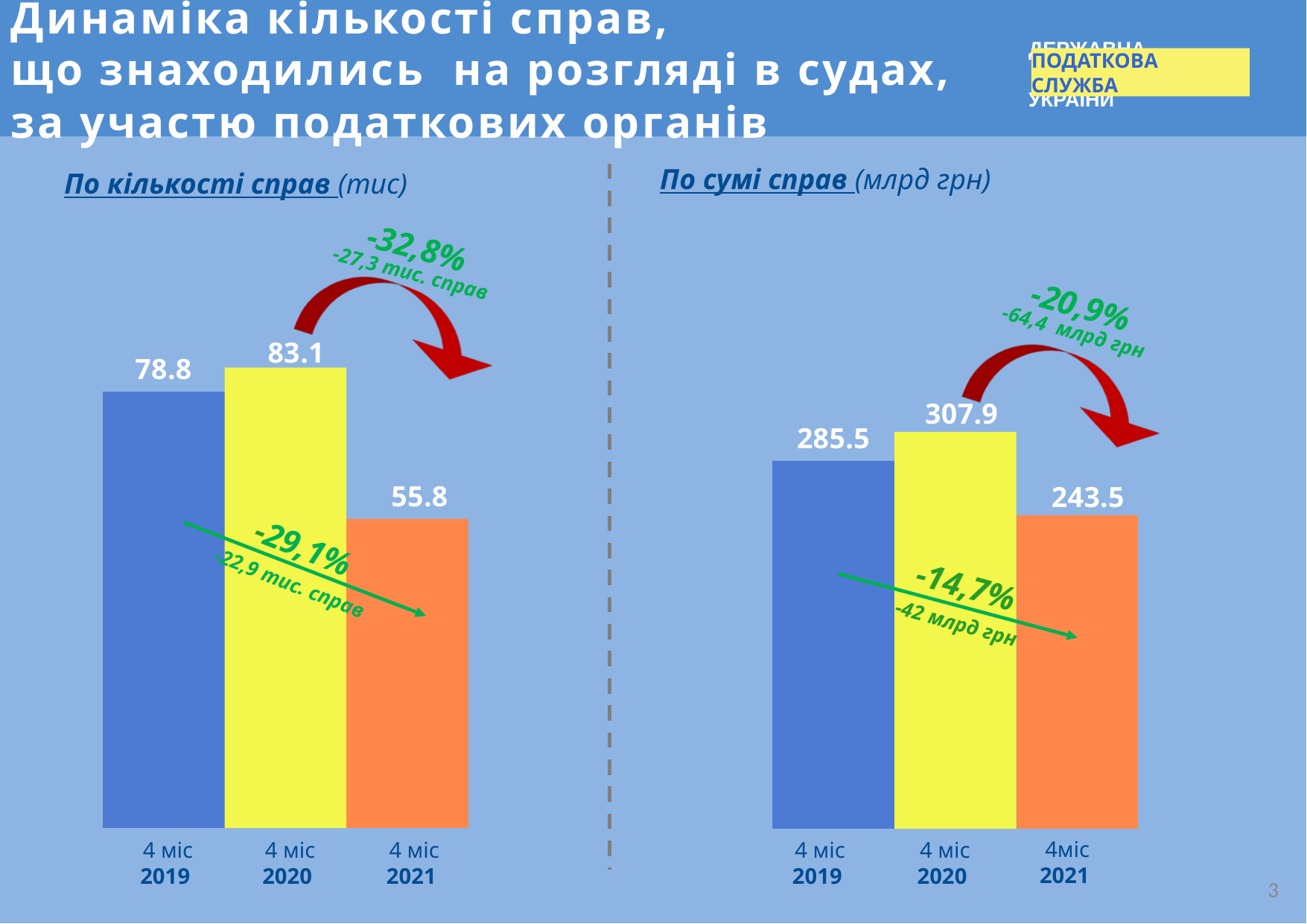
In the chart 'По сумі справ (млрд грн)', what is the difference between the values for 4 міс 2020 and 4 міс 2019? 22.4 In the chart 'По сумі справ (млрд грн)', what is the value for 4 міс 2021? 243.5 How many bars are shown in the chart 'По сумі справ (млрд грн)'? 3 In the chart 'По сумі справ (млрд грн)', which is larger: the value for 4 міс 2019 or 4 міс 2021? 4 міс 2019 What type of chart is used on the left side of the slide ('По кількості справ')? Bar chart In the chart 'По кількості справ (тис)', what is the value for 4 міс 2019? 78.8 In the chart 'По кількості справ (тис)', which is larger: the value for 4 міс 2019 or 4 міс 2020? 4 міс 2020 In the chart 'По сумі справ (млрд грн)', which period has the lowest value? 4 міс 2021 In the chart 'По кількості справ (тис)', what is the value for 4 міс 2020? 83.1 In the chart 'По кількості справ (тис)', which period has the highest value? 4 міс 2020 In the chart 'По кількості справ (тис)', what is the difference between the values for 4 міс 2020 and 4 міс 2021? 27.3 What percentage change is shown by the red arrow in the chart 'По сумі справ (млрд грн)'? -20,9%